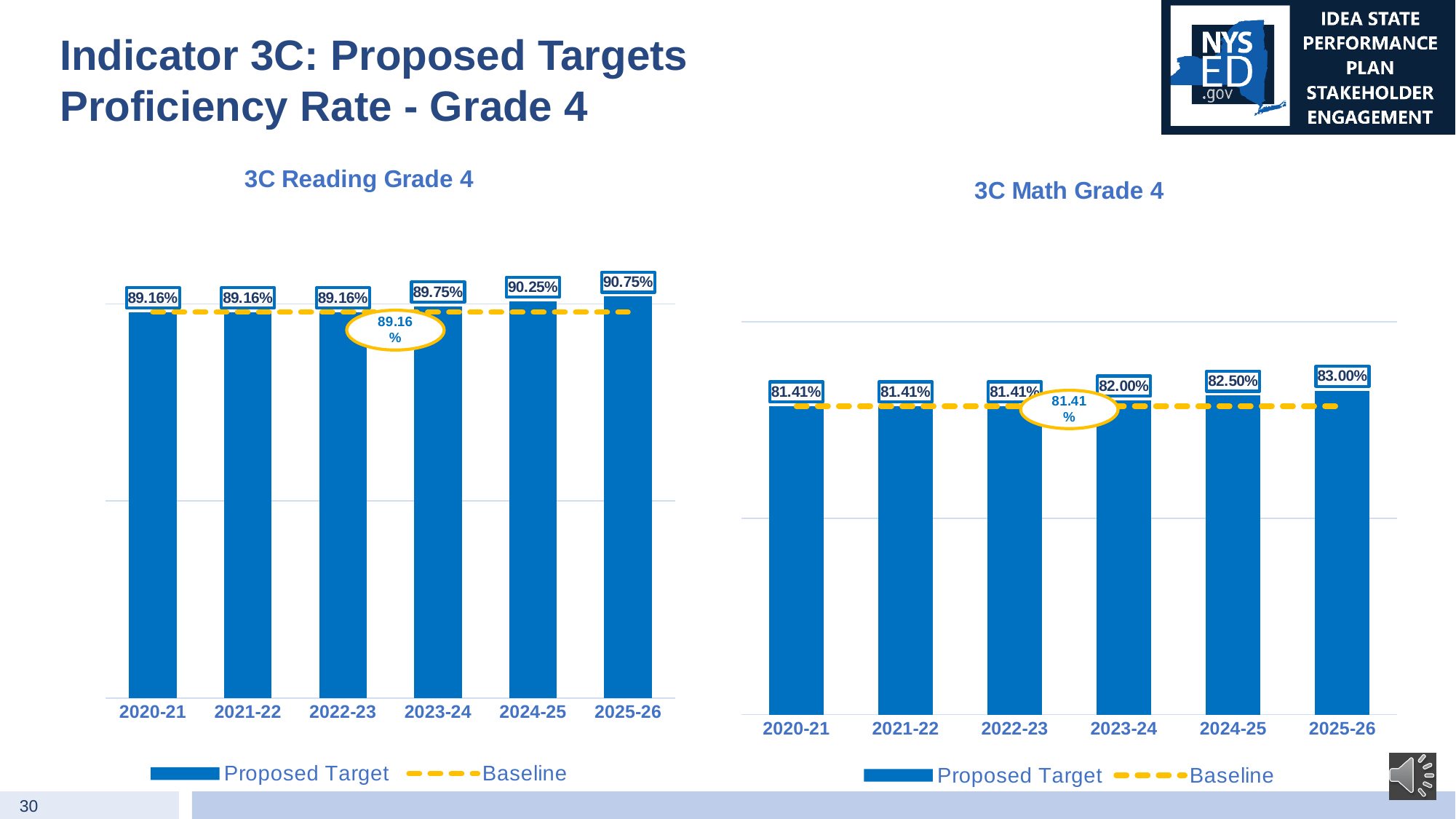
In the 3C Math Grade 4 chart, is the proposed target for 2024-25 larger or smaller than the proposed target for 2023-24? larger How many years are shown on the x axis of the 3C Reading Grade 4 chart? 6 What kind of chart is the 3C Reading Grade 4 chart? bar chart In the 3C Reading Grade 4 chart, what is the proposed target for 2025-26? 90.75% In the 3C Math Grade 4 chart, which year has the highest proposed target? 2025-26 In the 3C Reading Grade 4 chart, what is the baseline value shown? 89.16% In the 3C Reading Grade 4 chart, what is the difference between the proposed targets for 2025-26 and 2020-21? 1.59% In the 3C Math Grade 4 chart, what is the difference between the proposed targets for 2025-26 and 2024-25? 0.50% In the 3C Math Grade 4 chart, what is the baseline value shown? 81.41% How many series does the legend of the 3C Math Grade 4 chart list? 2 In the 3C Reading Grade 4 chart, which year has the highest proposed target? 2025-26 In the 3C Math Grade 4 chart, what is the proposed target for 2023-24? 82.00%